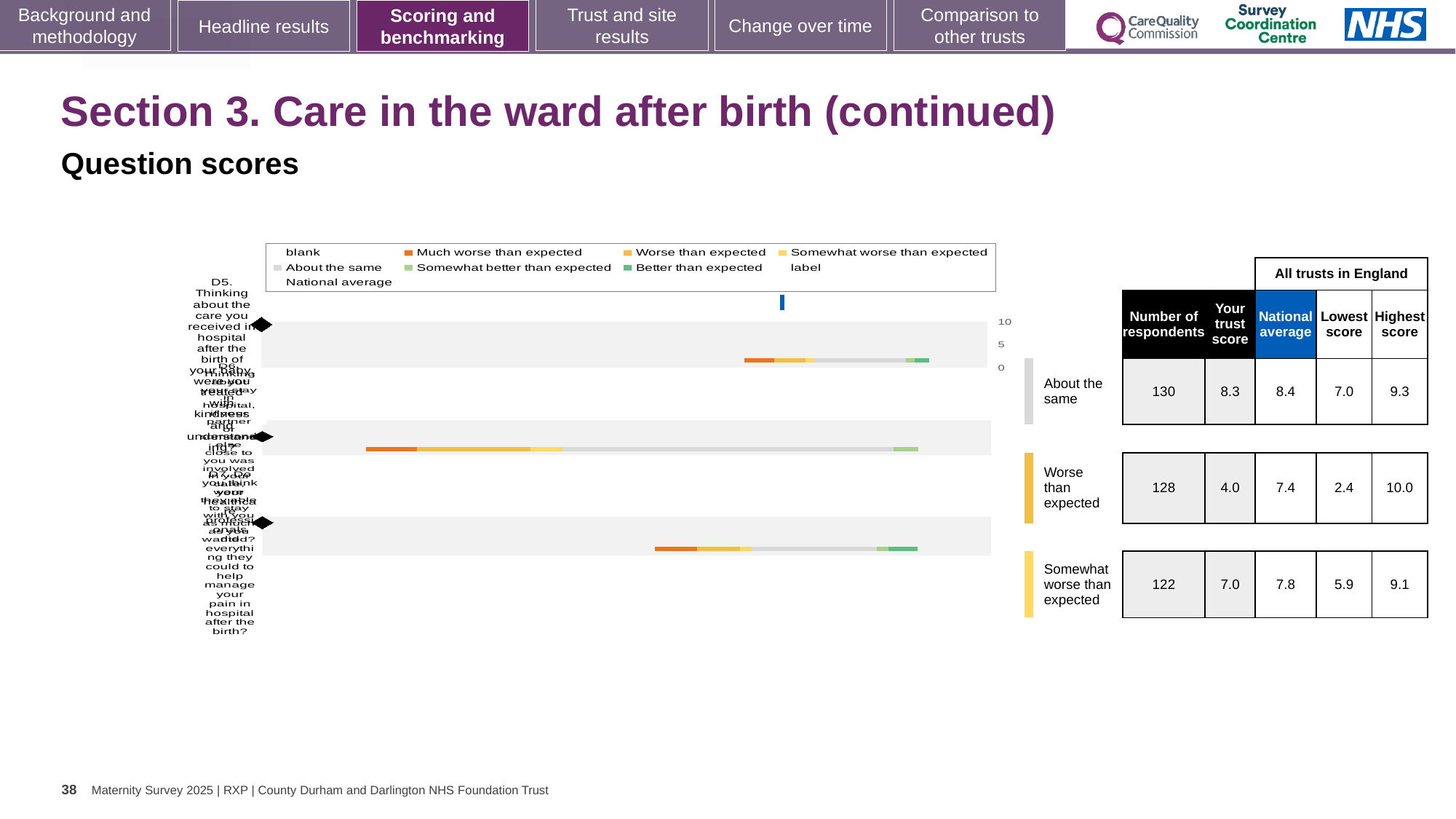
In the table beside the chart, what is the number of respondents for the row labelled 'About the same'? 130 In the table beside the chart, what is 'Your trust score' for the row labelled 'Worse than expected'? 4.0 In the table beside the chart, what is the national average for the row labelled 'Somewhat worse than expected'? 7.8 In the table beside the chart, what is the lowest score for the row labelled 'Worse than expected'? 2.4 In the table beside the chart, which row has the lowest 'Your trust score'? Worse than expected In the table beside the chart, for the row labelled 'About the same', which is larger: 'Your trust score' or the national average? National average In the table beside the chart, for the row labelled 'Worse than expected', what is the difference between the national average and 'Your trust score'? 3.4 In the chart legend, what colour represents 'Much worse than expected'? orange What is the highest tick value shown on the chart's axis? 10 What kind of chart is shown on the slide? bar chart How many question rows (bars) are plotted in the chart? 3 In the table beside the chart, which row has the highest 'Highest score' value? Worse than expected